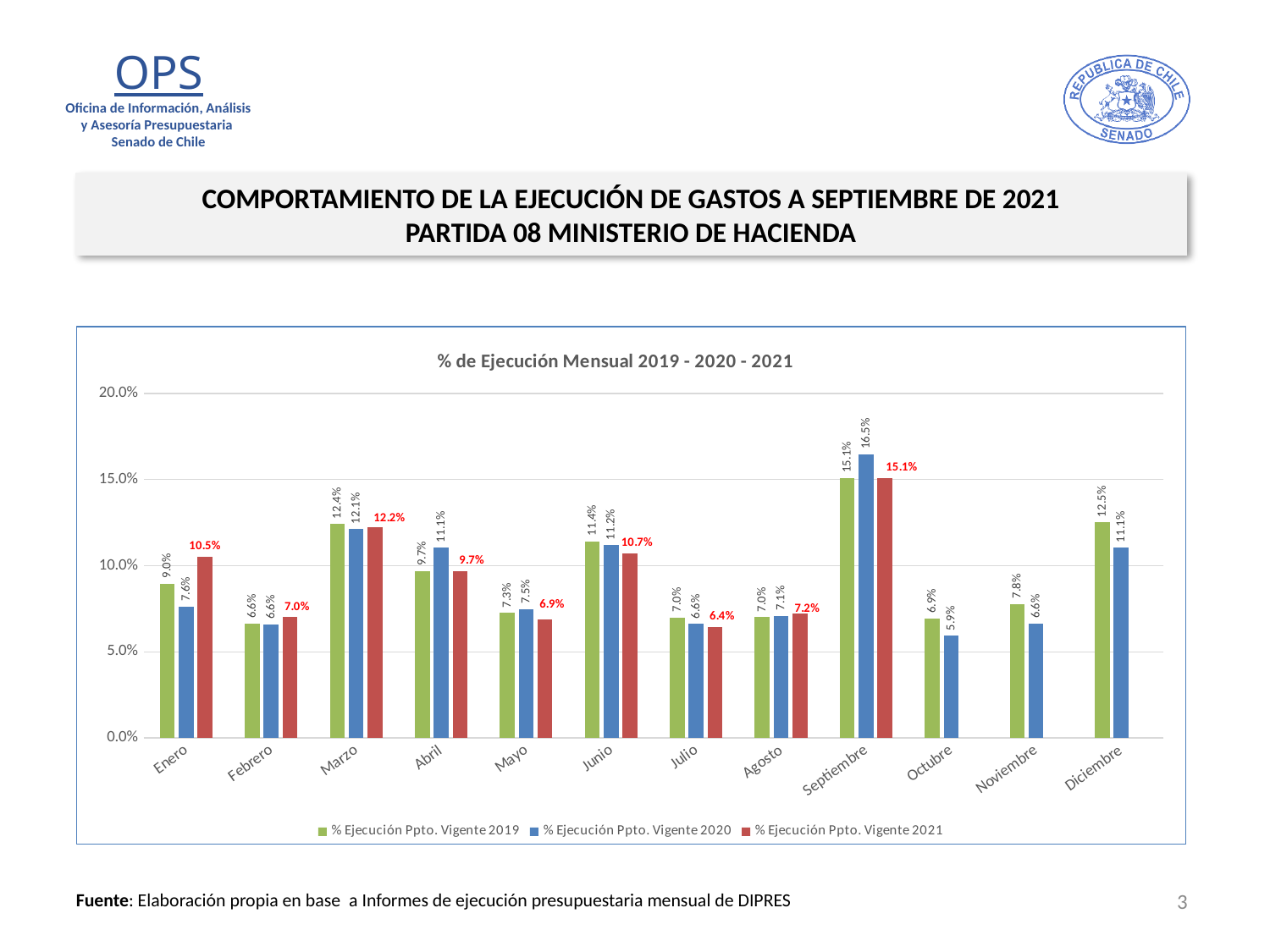
Which month has the lowest value in the % Ejecución Ppto. Vigente 2021 series? Julio For Abril, which series has the larger value: % Ejecución Ppto. Vigente 2019 or % Ejecución Ppto. Vigente 2020? % Ejecución Ppto. Vigente 2020 What is the difference between the 2021 and 2019 values for Enero? 1.5% What is the value for Octubre in the % Ejecución Ppto. Vigente 2020 series? 5.9% What is the value for Enero in the % Ejecución Ppto. Vigente 2021 series? 10.5% Which month has the highest value in the % Ejecución Ppto. Vigente 2021 series? Septiembre How many series does the legend list? 3 How many months are shown on the x axis of the chart? 12 What kind of chart is shown on the slide? Bar chart What is the value for Septiembre in the % Ejecución Ppto. Vigente 2020 series? 16.5% What is the difference between the 2020 and 2019 values for Septiembre? 1.4% Which month has the lowest value in the % Ejecución Ppto. Vigente 2020 series? Octubre